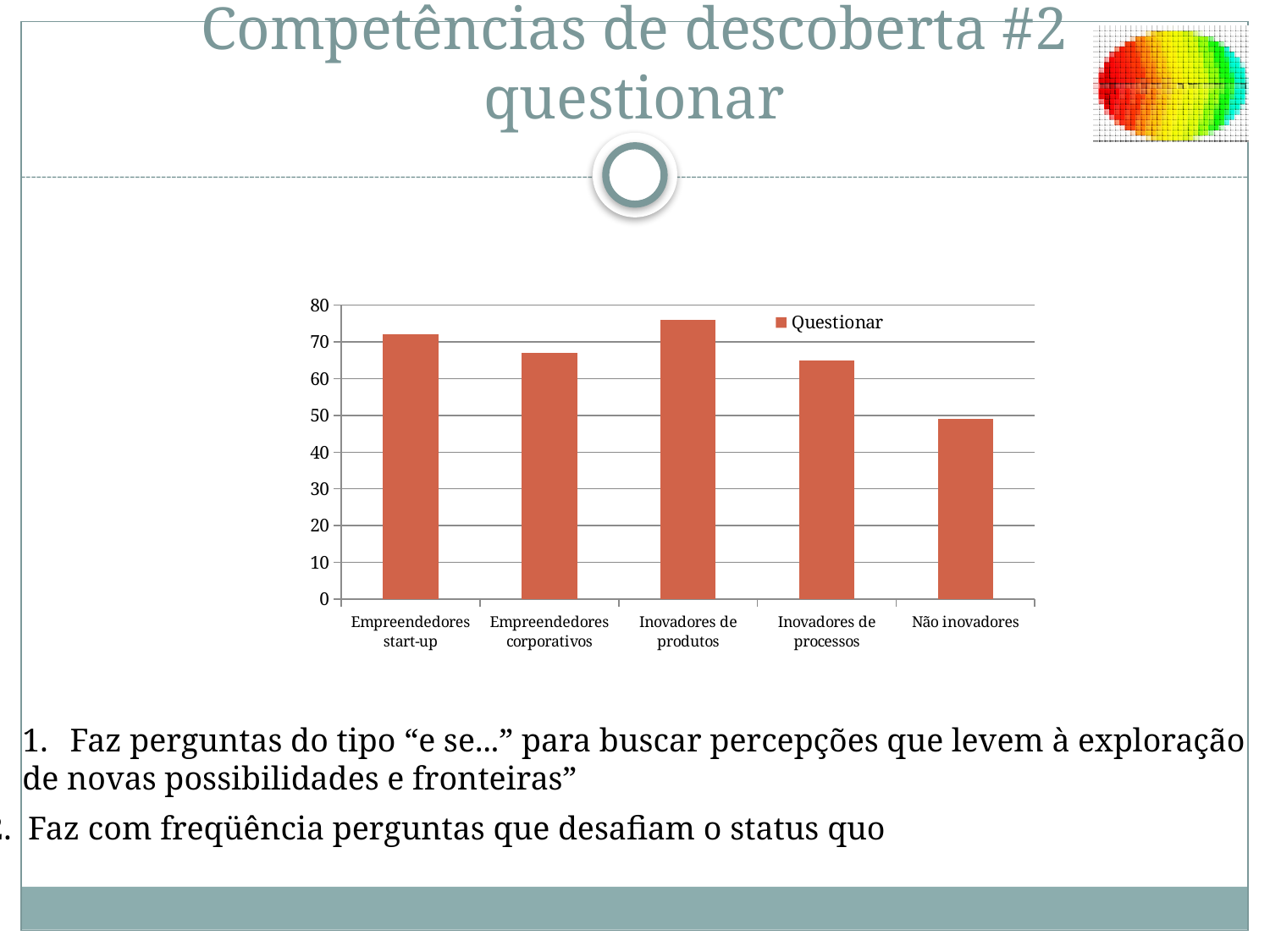
Is the value for Inovadores de processos greater or less than 60? greater Is the value for Empreendedores corporativos greater or less than 60? greater Is the value for Não inovadores greater or less than 60? less How many series does the chart's legend list? 1 Which is larger, the value for Inovadores de processos or the value for Não inovadores? Inovadores de processos What kind of chart is shown on the slide? bar chart How many categories are shown on the x axis of the chart? 5 Which category has the highest bar in the chart? Inovadores de produtos What is the name of the series shown in the chart's legend? Questionar Which is larger, the value for Empreendedores start-up or the value for Empreendedores corporativos? Empreendedores start-up Which category has the lowest bar in the chart? Não inovadores